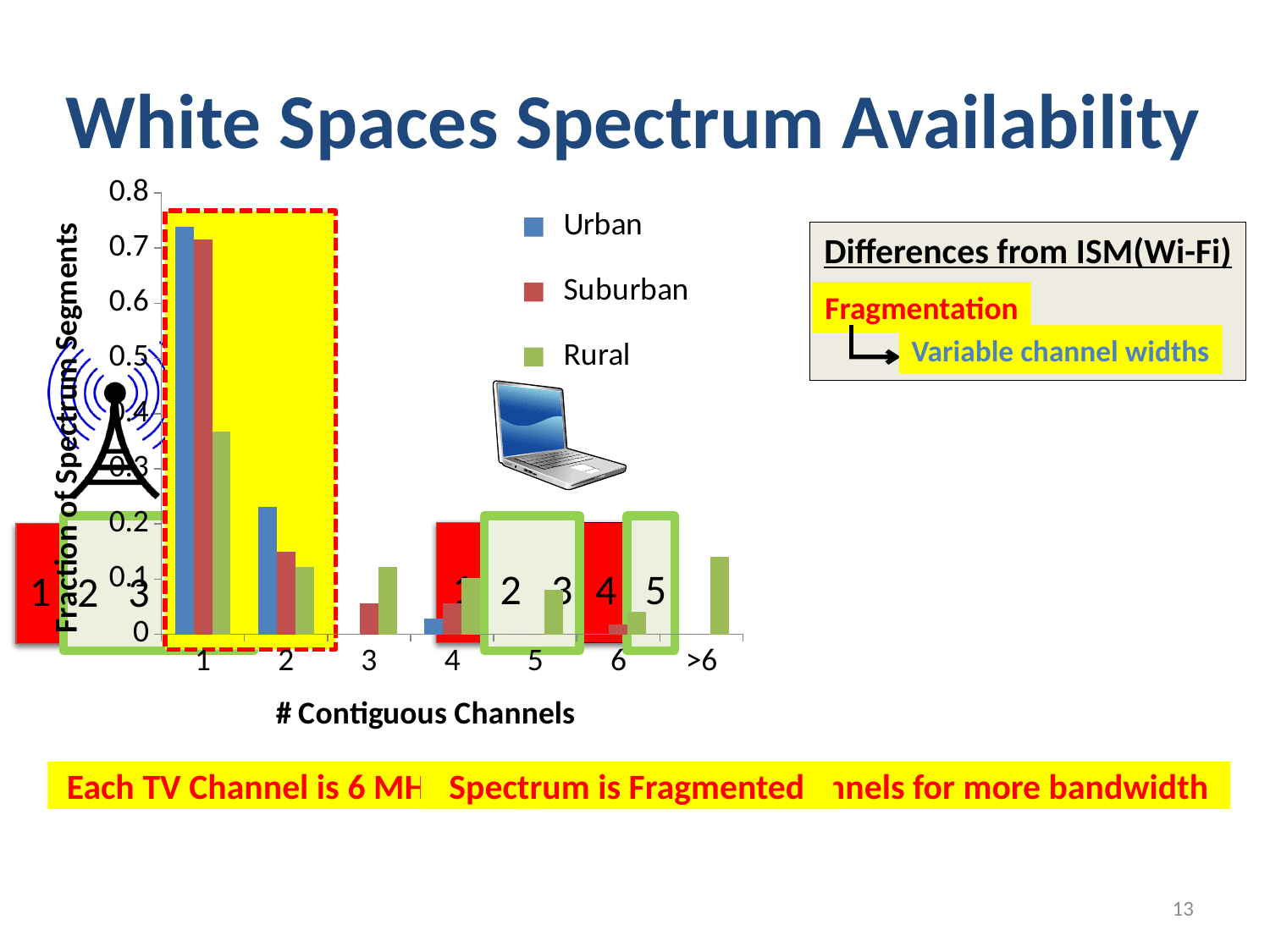
Is the Urban value for 1 contiguous channel greater or less than 0.6? greater What is the title of the x axis of the chart? # Contiguous Channels For 2 contiguous channels, which is larger: the Urban value or the Suburban value? Urban How many categories are shown on the x axis of the chart? 7 For 1 contiguous channel, which is larger: the Urban value or the Rural value? Urban How many series does the chart legend list? 3 Is the Rural value for 1 contiguous channel greater or less than 0.5? less What kind of chart is shown on the slide? bar chart Is the Urban value for 2 contiguous channels greater or less than 0.3? less Which colour represents the Urban series in the chart legend? blue Do the Urban values rise or fall as the number of contiguous channels increases from 1 to 3? fall For which number of contiguous channels is the Urban series highest? 1